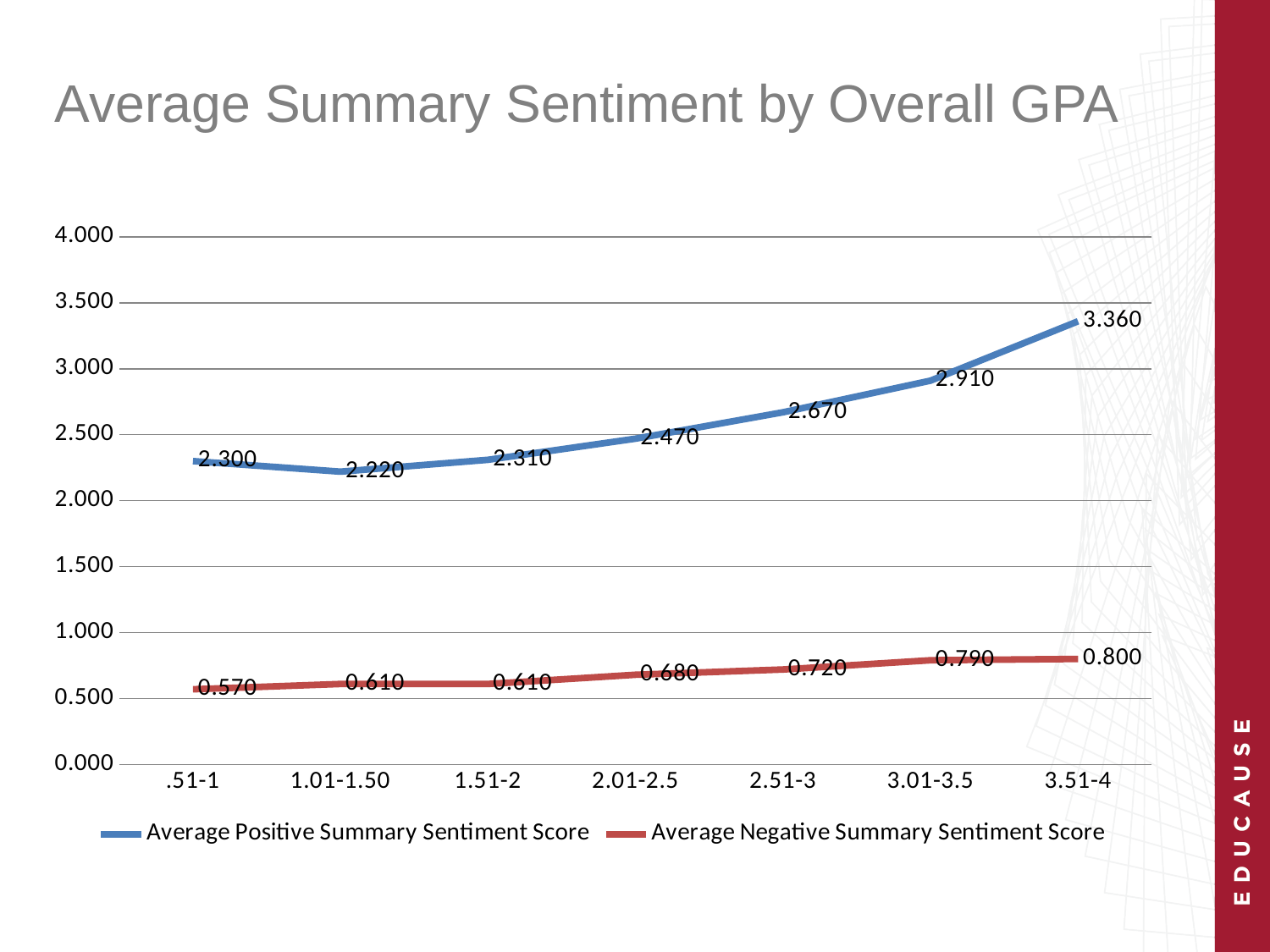
What is the difference between the Average Positive Summary Sentiment Score for 3.51-4 and for 3.01-3.5? 0.450 What kind of chart is shown on the slide? Line chart What is the Average Positive Summary Sentiment Score for the 2.01-2.5 GPA range? 2.470 Is the Average Positive Summary Sentiment Score for 2.51-3 greater or less than 2.500? greater Which GPA range has the highest Average Negative Summary Sentiment Score? 3.51-4 How many series does the legend list? 2 Which GPA range has the lowest Average Positive Summary Sentiment Score? 1.01-1.50 Which is larger: the Average Negative Summary Sentiment Score for 2.51-3 or for 3.01-3.5? 3.01-3.5 How many GPA ranges are shown on the x axis? 7 What is the Average Positive Summary Sentiment Score for the 3.51-4 GPA range? 3.360 What is the Average Negative Summary Sentiment Score for the .51-1 GPA range? 0.570 Does the Average Negative Summary Sentiment Score generally rise or fall as GPA increases? Rise